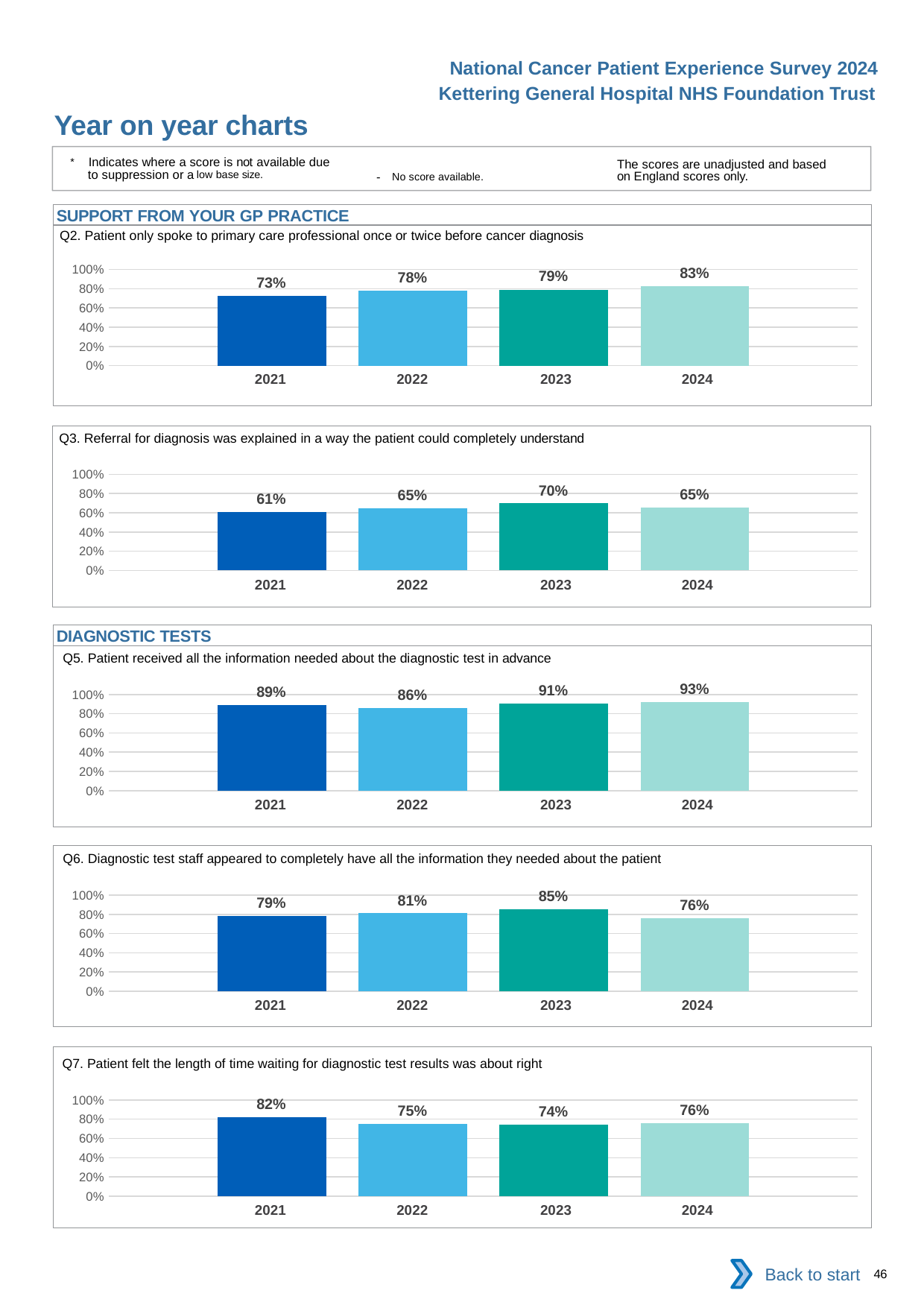
In the Q2 chart, what is the value for 2024? 83% In the Q3 chart, what is the value for 2021? 61% What is the title of the chart in the DIAGNOSTIC TESTS section that shows 93% for 2024? Q5. Patient received all the information needed about the diagnostic test in advance In the Q3 chart, which year has the highest value? 2023 In the Q7 chart, which is larger, the value for 2021 or the value for 2022? 2021 In the Q7 chart, what is the value for 2023? 74% What kind of chart is the Q5 chart? bar chart How many years are shown in the Q3 chart? 4 In the Q2 chart, do the values rise or fall from 2021 to 2024? rise In the Q6 chart, what is the difference between the 2023 and 2024 values? 9% In the Q6 chart, which year has the highest value? 2023 In the Q5 chart, which year has the lowest value? 2022